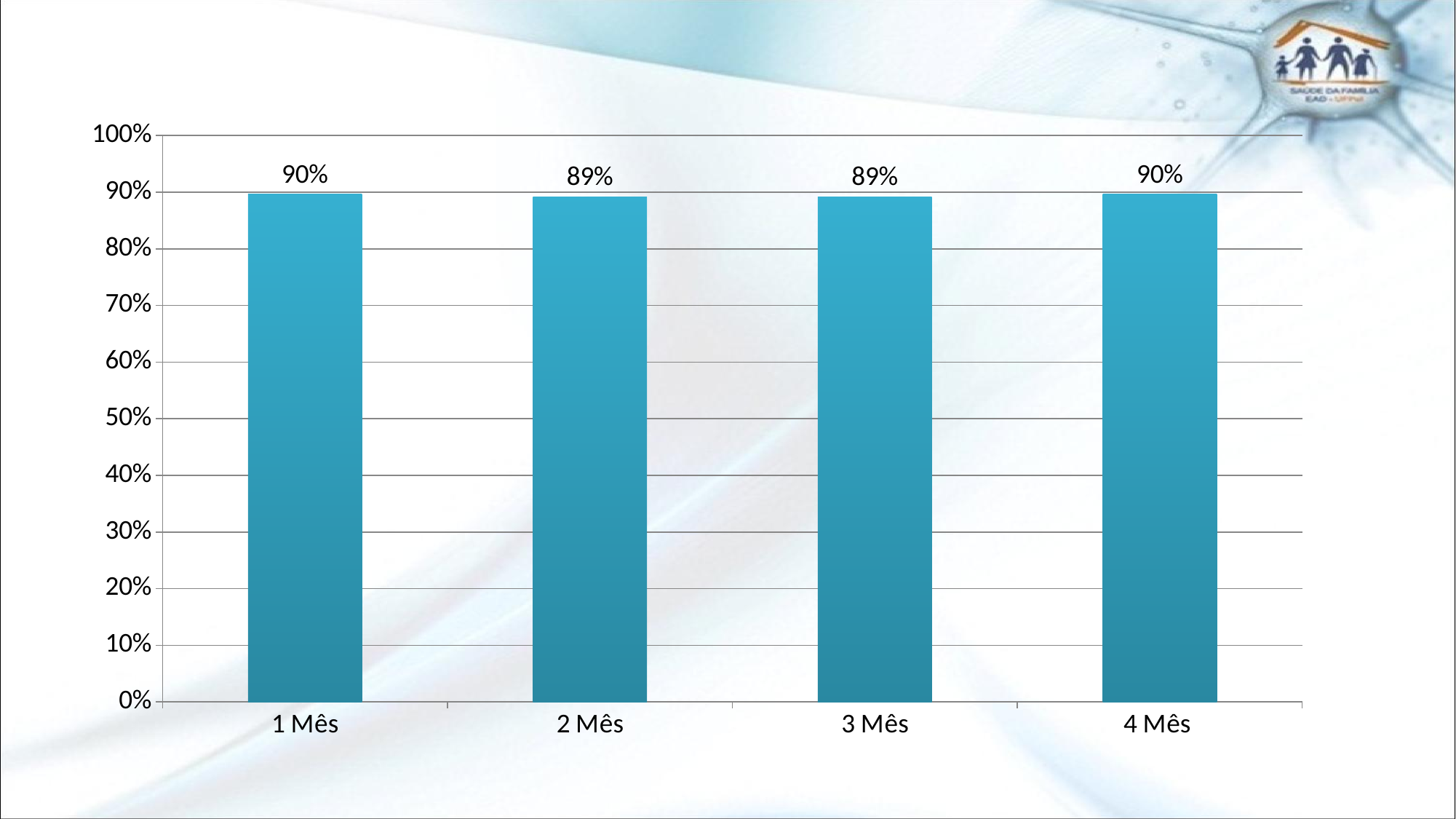
Which has the larger value, 1 Mês or 3 Mês? 1 Mês Do the values rise, fall, or stay roughly flat from 1 Mês to 4 Mês? stay roughly flat What is the value for 1 Mês? 90% What is the value for 2 Mês? 89% What is the highest value shown on the y axis? 100% What is the value for 3 Mês? 89% What kind of chart is shown on the slide? bar chart How many categories are shown on the x axis? 4 What is the value for 4 Mês? 90% What is the difference between the values for 1 Mês and 2 Mês? 1% Is the value for 3 Mês greater or less than 80%? greater Is the value for 4 Mês greater or less than 100%? less